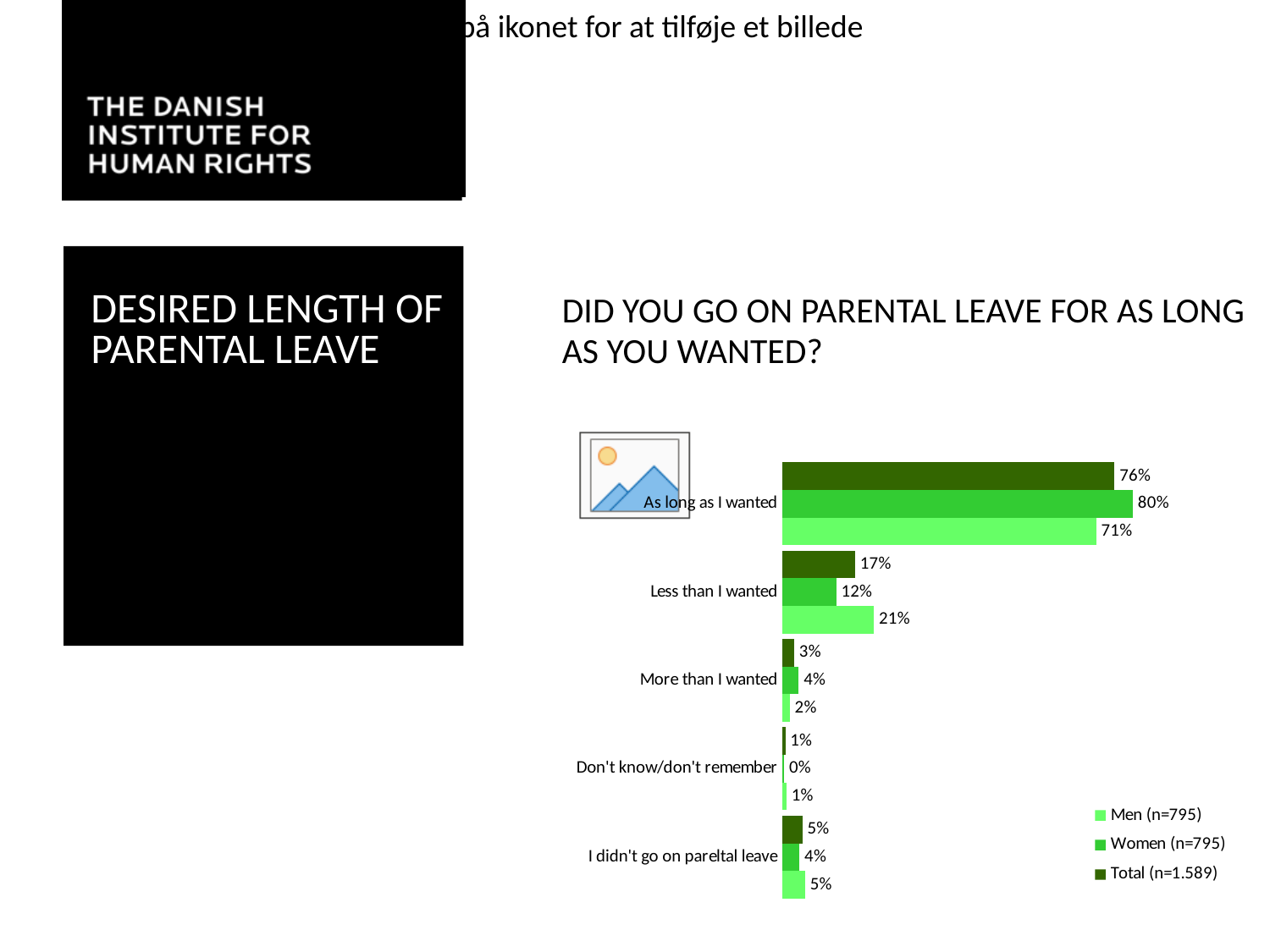
What is the Total value for "Less than I wanted"? 17% What is the Men value for "More than I wanted"? 2% How many response categories are shown on the chart? 5 Which response category has the lowest Total value? Don't know/don't remember What percentage of men answered "Less than I wanted"? 21% What percentage of women answered "Don't know/don't remember"? 0% What kind of chart is shown on the slide? Bar chart For "Less than I wanted", which is larger: the Men value or the Women value? Men How many series does the legend list? 3 Which response category has the highest Total value? As long as I wanted What is the difference between the Women and Men values for "As long as I wanted"? 9% What percentage of women answered "As long as I wanted"? 80%